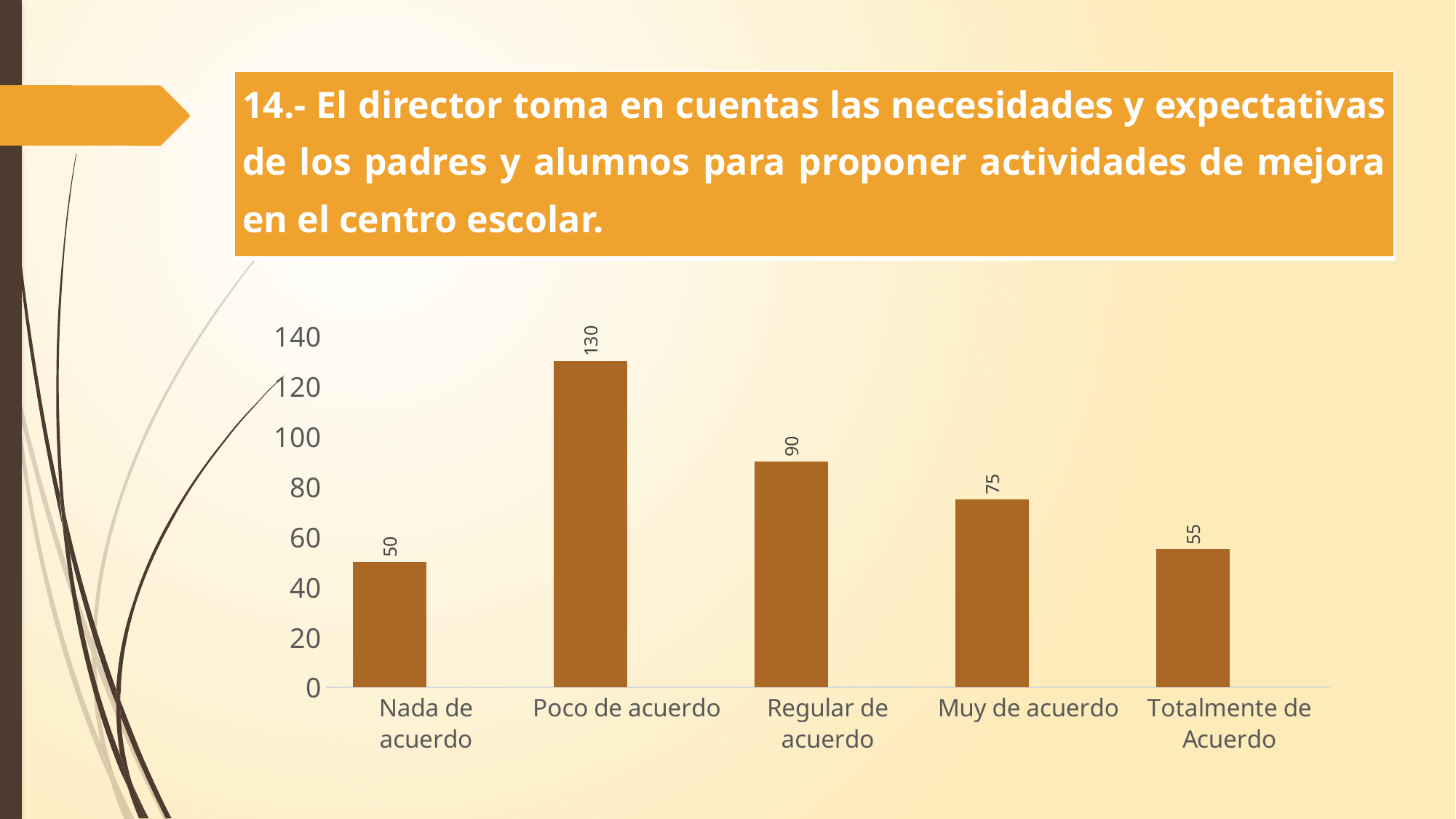
Which category has the highest value? Poco de acuerdo What is the value for "Nada de acuerdo"? 50 What is the difference between the values for "Poco de acuerdo" and "Regular de acuerdo"? 40 Which is larger, the value for "Regular de acuerdo" or the value for "Muy de acuerdo"? Regular de acuerdo What kind of chart is shown on the slide? bar chart What is the highest value shown on the vertical axis? 140 What is the difference between the values for "Muy de acuerdo" and "Totalmente de Acuerdo"? 20 Which category has the lowest value? Nada de acuerdo What is the value for "Totalmente de Acuerdo"? 55 What is the value for "Poco de acuerdo"? 130 Is the value for "Muy de acuerdo" greater or less than 100? less How many categories are shown on the x axis? 5